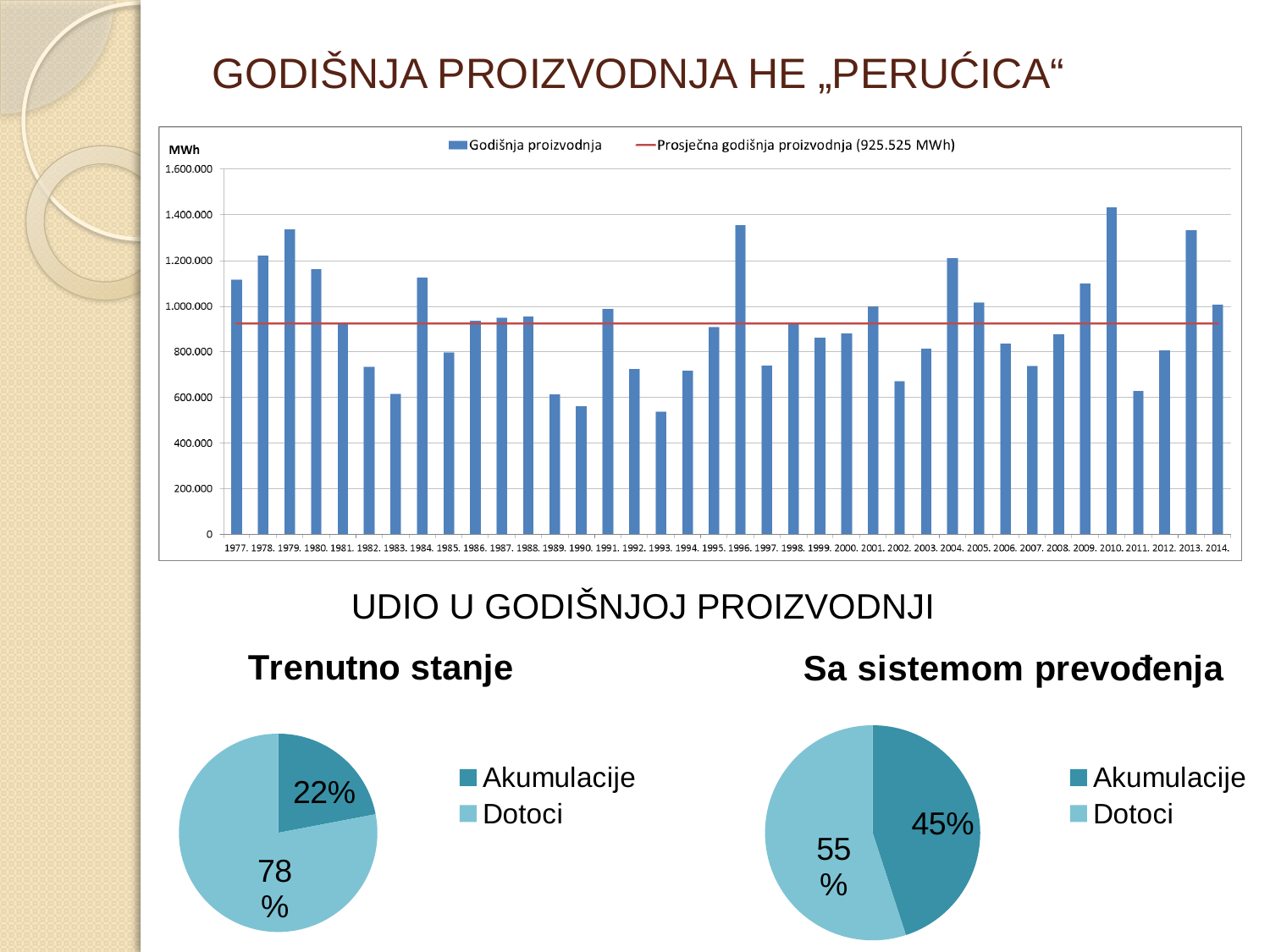
In the top bar chart, is the value for 1993 greater or less than 600.000? less In the top bar chart, how many years are shown on the x axis? 38 In the top bar chart, which year has the higher production, 1978 or 1979? 1979. In the top bar chart, what is the average annual production stated in the legend? 925.525 MWh In the top bar chart, how many series does the legend list? 2 In the pie chart titled "Sa sistemom prevođenja", what share does Dotoci have? 55% In the pie chart titled "Trenutno stanje", what share does Akumulacije have? 22% In the top bar chart, which year has the highest annual production? 2010. In the top bar chart, which year has the higher production, 2013 or 2014? 2013. What type of chart is the top chart titled "GODIŠNJA PROIZVODNJA HE „PERUĆICA“"? bar chart In the top bar chart, is the value for 2010 greater or less than 1.200.000? greater In the pie chart titled "Sa sistemom prevođenja", what is the difference between the Dotoci and Akumulacije shares? 10%